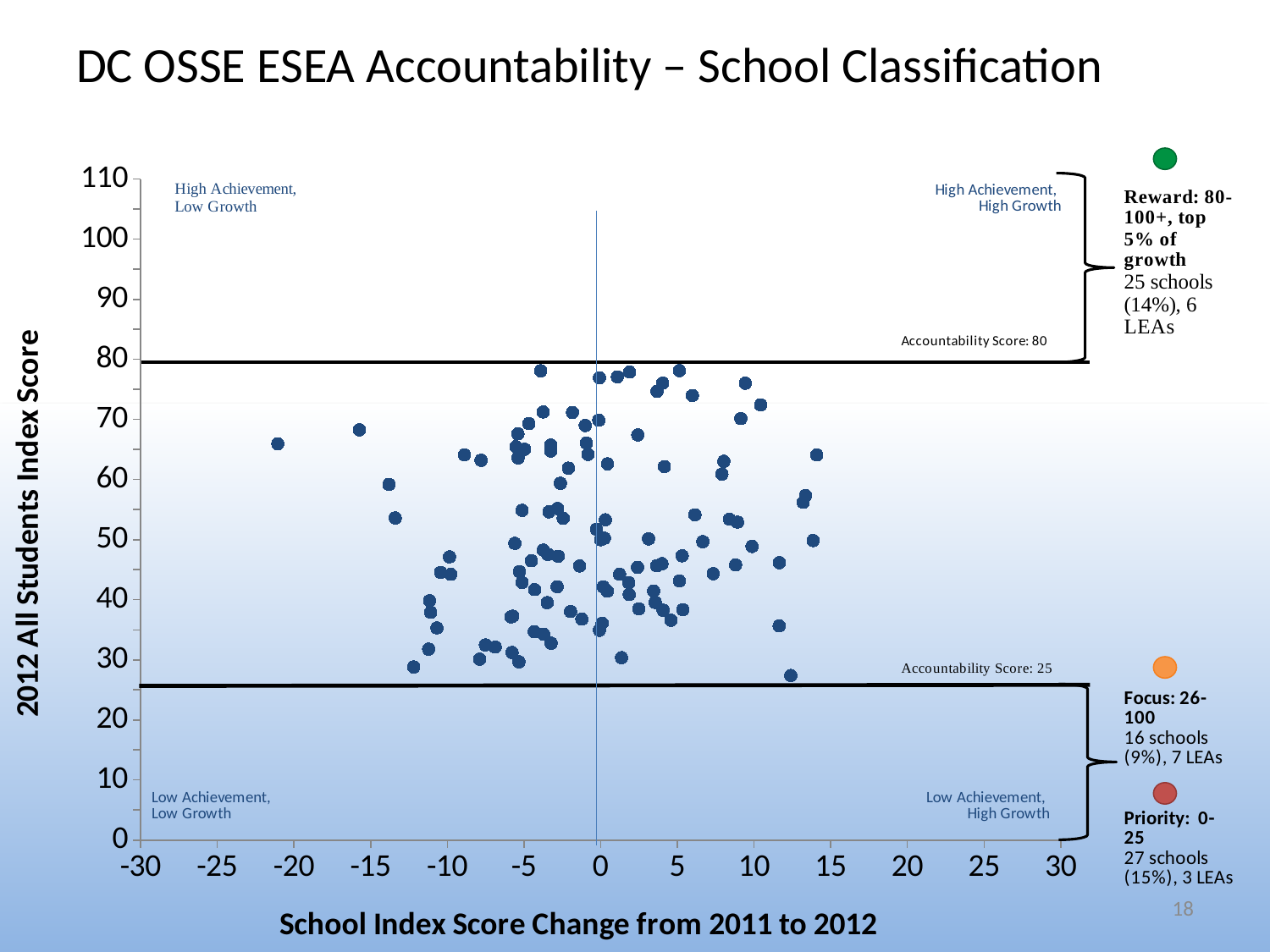
What is the difference in the number of schools between the Priority and Focus categories shown in the annotations? 11 Which category has more schools according to the annotations: Reward or Priority? Priority What kind of chart is shown on the slide? Scatter chart How many schools are in the Reward category according to the annotation on the chart? 25 schools What is the score range given for the Focus category in the annotation? 26-100 What percentage of schools are in the Focus category according to the annotation on the chart? 9% What is the maximum value shown on the horizontal axis of the chart? 30 How many LEAs are in the Priority category according to the annotation on the chart? 3 LEAs At what value is the upper horizontal reference line labelled 'Accountability Score' drawn? 80 At what value is the lower horizontal reference line labelled 'Accountability Score' drawn? 25 What is the label of the vertical axis of the chart? 2012 All Students Index Score What is the title of the chart on the slide? DC OSSE ESEA Accountability – School Classification